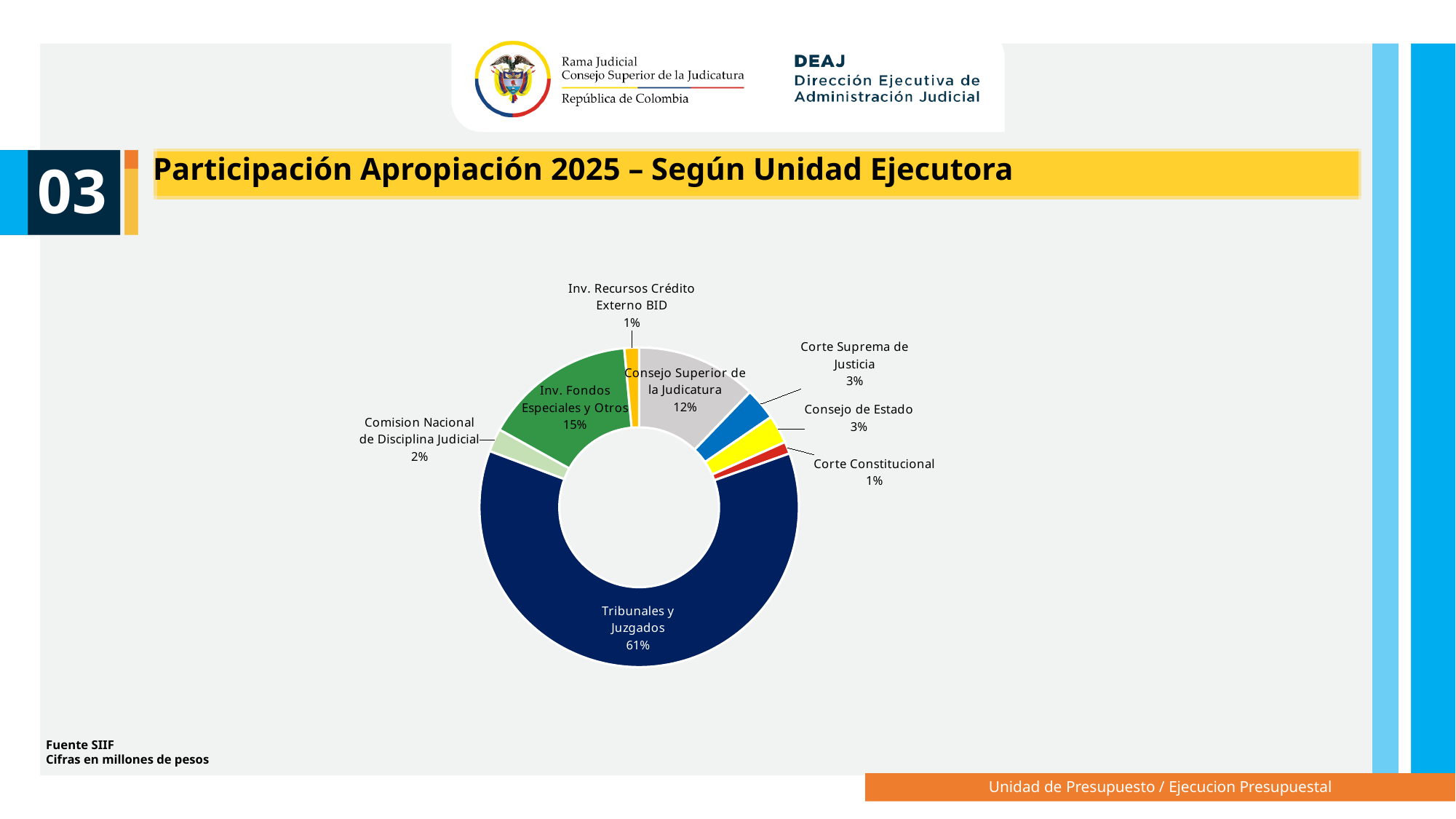
What type of chart is used on this slide? Doughnut chart What share is shown for Inv. Recursos Crédito Externo BID? 1% What is the title of the slide containing the chart? Participación Apropiación 2025 – Según Unidad Ejecutora Which unit has the largest share of the 2025 appropriation? Tribunales y Juzgados Which is larger: the share for Inv. Fondos Especiales y Otros or for Consejo Superior de la Judicatura? Inv. Fondos Especiales y Otros What percentage is labelled for Comision Nacional de Disciplina Judicial? 2% What percentage is shown for Inv. Fondos Especiales y Otros? 15% What percentage is shown for Consejo Superior de la Judicatura? 12% How many percentage points larger is the Tribunales y Juzgados share than the Inv. Fondos Especiales y Otros share? 46 percentage points What share does Corte Suprema de Justicia have in the chart? 3% What share of the 2025 appropriation goes to Tribunales y Juzgados? 61% How many executing units (slices) are shown in the chart? 8